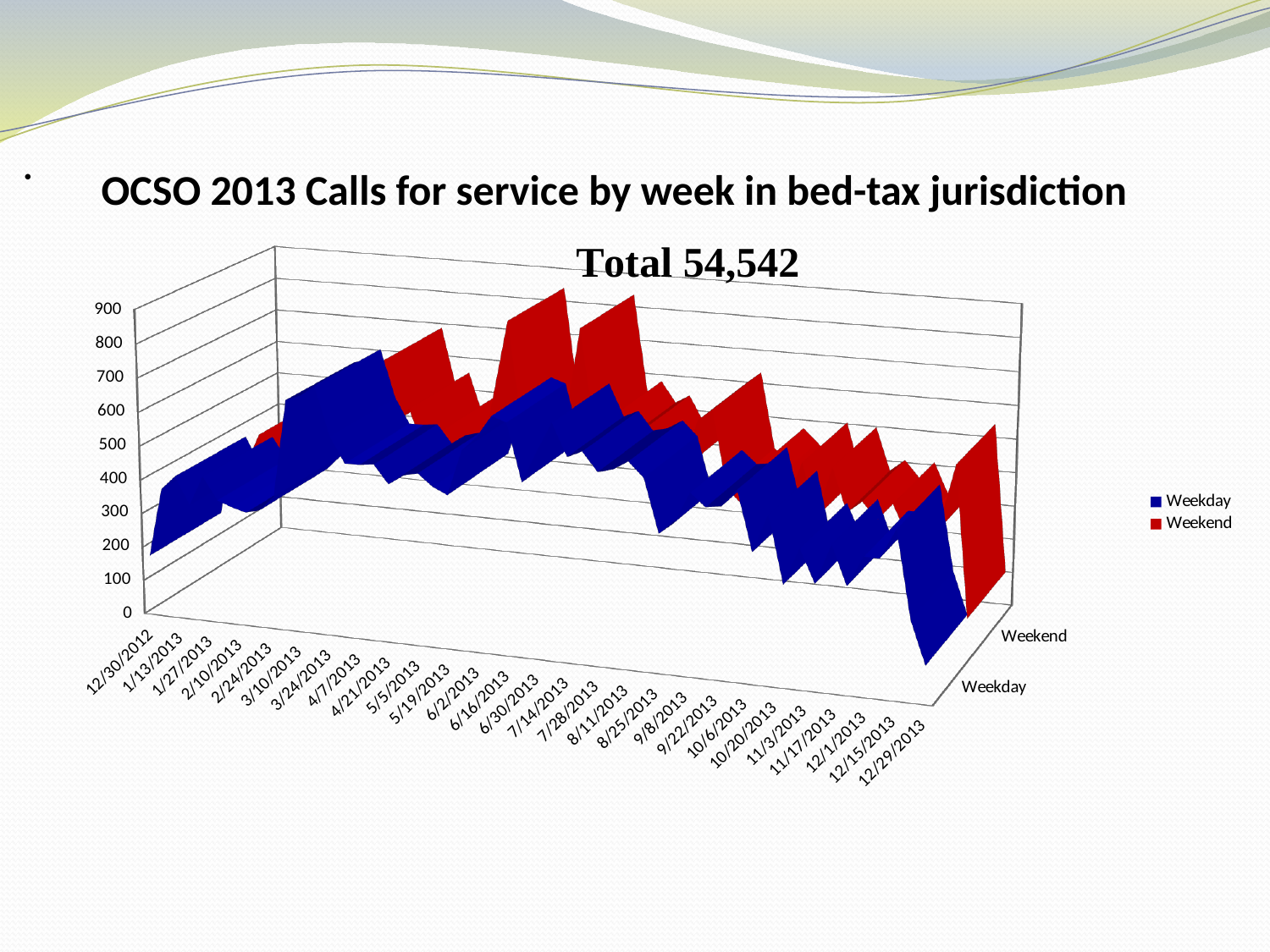
What is the first date label on the x axis? 12/30/2012 What kind of chart is shown on the slide? 3D line chart How many series does the legend list? 2 Is the Weekday value for 12/30/2012 greater or less than 400? less What is the title of the chart? OCSO 2013 Calls for service by week in bed-tax jurisdiction What are the two series named in the legend? Weekday and Weekend What total is printed on the chart? Total 54,542 What is the last date label on the x axis? 12/29/2013 Which colour represents the Weekend series? red Do the Weekday values at the end of the year (around 12/29/2013) appear higher or lower than the values in mid-year? lower